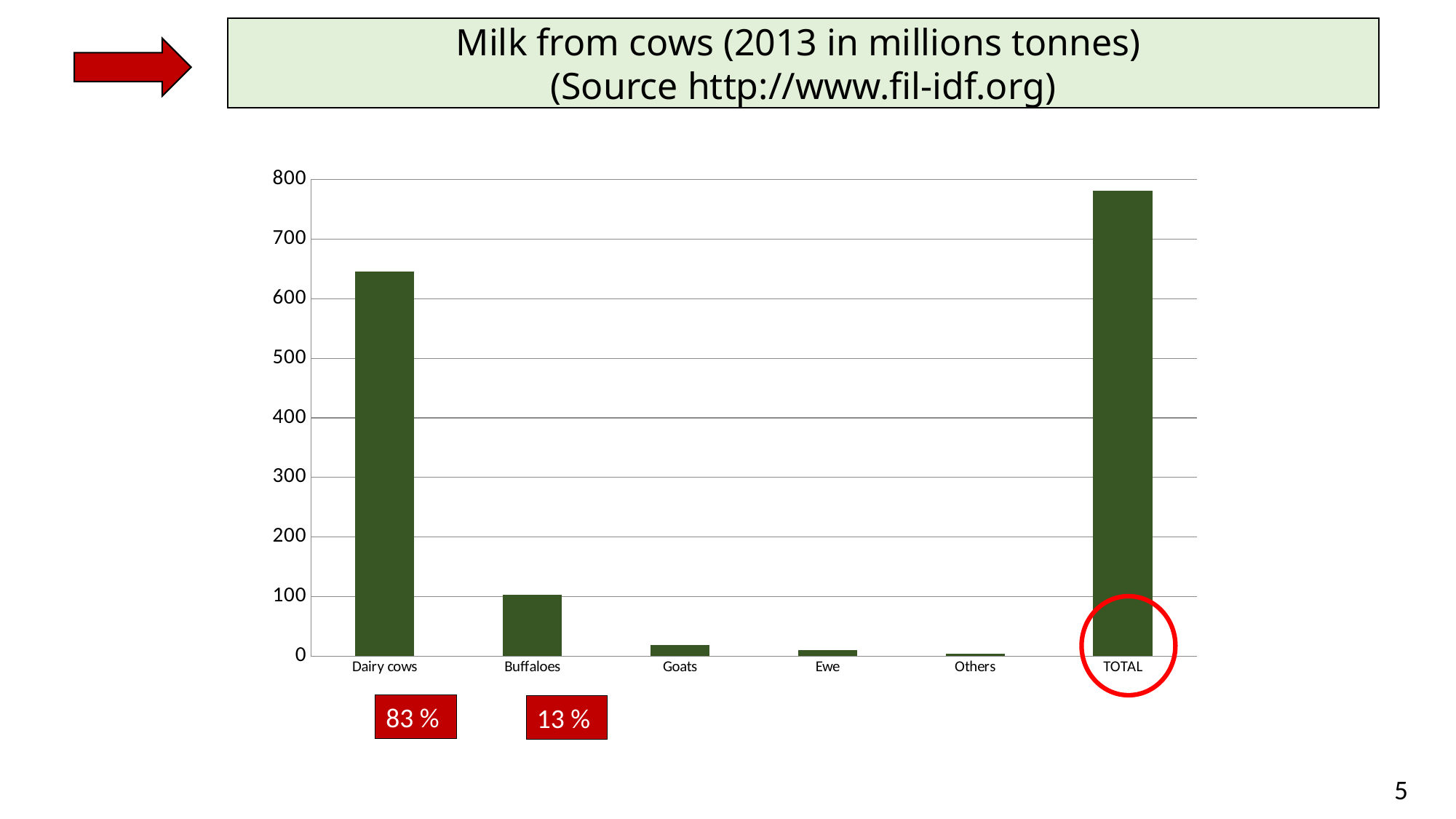
Is the value for Buffaloes greater or less than 200? less Which is larger, the value for Dairy cows or the value for Buffaloes? Dairy cows Is the value for Dairy cows greater or less than 600? greater Which category has the shortest bar in the chart? Others What percentage label is shown in the red box under the Dairy cows bar? 83 % How many categories are shown on the x axis of the chart? 6 Is the value for Dairy cows greater or less than 700? less Which category has the tallest bar in the chart? TOTAL Which is larger, the value for Goats or the value for Ewe? Goats What kind of chart is shown on the slide? bar chart